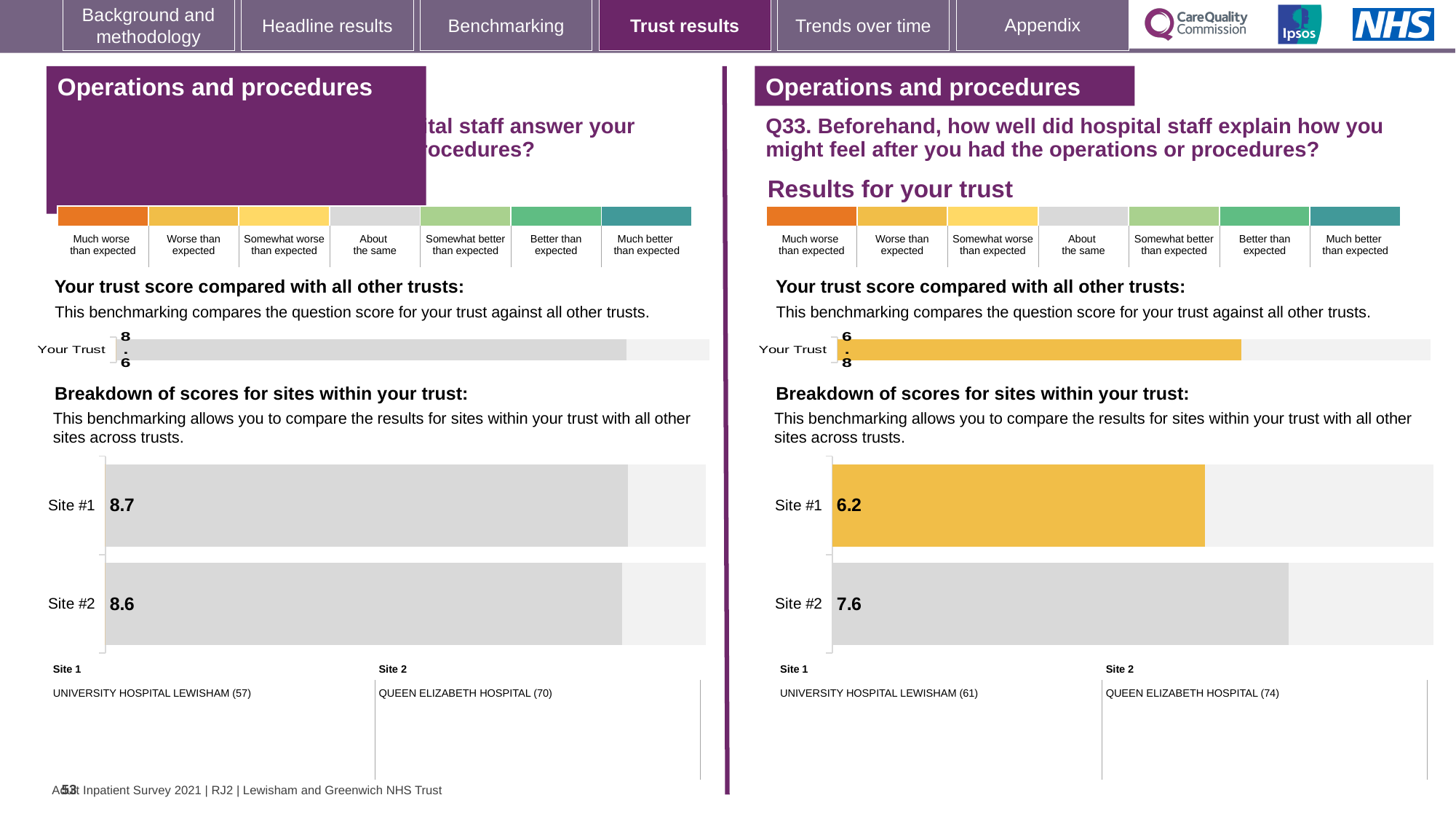
On the left-hand panel, what is the difference between the Site #1 score and the Site #2 score? 0.1 On the right-hand panel (Q33), which site has the lower score in the site breakdown chart? Site #1 On the right-hand panel (Q33), what is the difference between the Site #2 score and the Site #1 score? 1.4 What type of chart is used for the breakdown of scores for sites on the right-hand panel (Q33)? Bar chart On the right-hand panel (Q33), what is the score for Site #1 in the breakdown of scores for sites within your trust? 6.2 On the right-hand panel (Q33), which site has the higher score in the site breakdown chart? Site #2 On the left-hand panel, what is the score for Site #2 in the breakdown of scores for sites within your trust? 8.6 How many sites are shown in the site breakdown chart on the right-hand panel (Q33)? 2 On the left-hand panel, what is the 'Your Trust' score in the chart comparing your trust with all other trusts? 8.6 On the right-hand panel (Q33), what is the 'Your Trust' score in the chart comparing your trust with all other trusts? 6.8 On the left-hand panel, what is the score for Site #1 in the breakdown of scores for sites within your trust? 8.7 On the right-hand panel (Q33), what is the score for Site #2 in the breakdown of scores for sites within your trust? 7.6